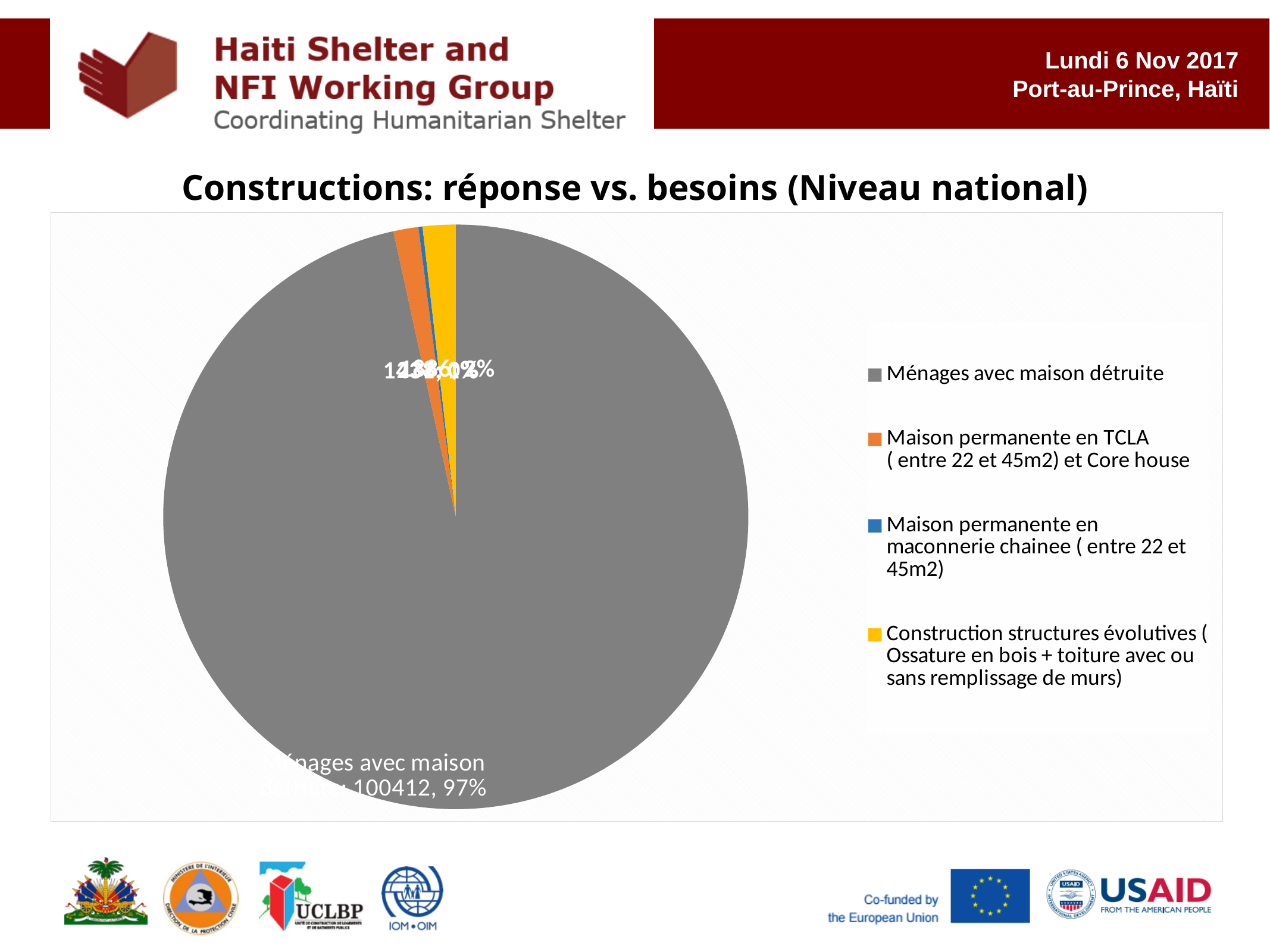
How many entries does the legend list? 4 Which category has the largest slice of the pie? Ménages avec maison détruite What value is shown for Ménages avec maison détruite? 100412 What kind of chart is shown on the slide? pie chart What share of the pie does Ménages avec maison détruite represent? 97% What is the title of the chart? Constructions: réponse vs. besoins (Niveau national) How many slices does the pie chart have? 4 Which is larger: Ménages avec maison détruite or Maison permanente en TCLA ( entre 22 et 45m2) et Core house? Ménages avec maison détruite Which category has the smallest slice of the pie? Maison permanente en maconnerie chainee ( entre 22 et 45m2) What colour is the slice for Ménages avec maison détruite? grey